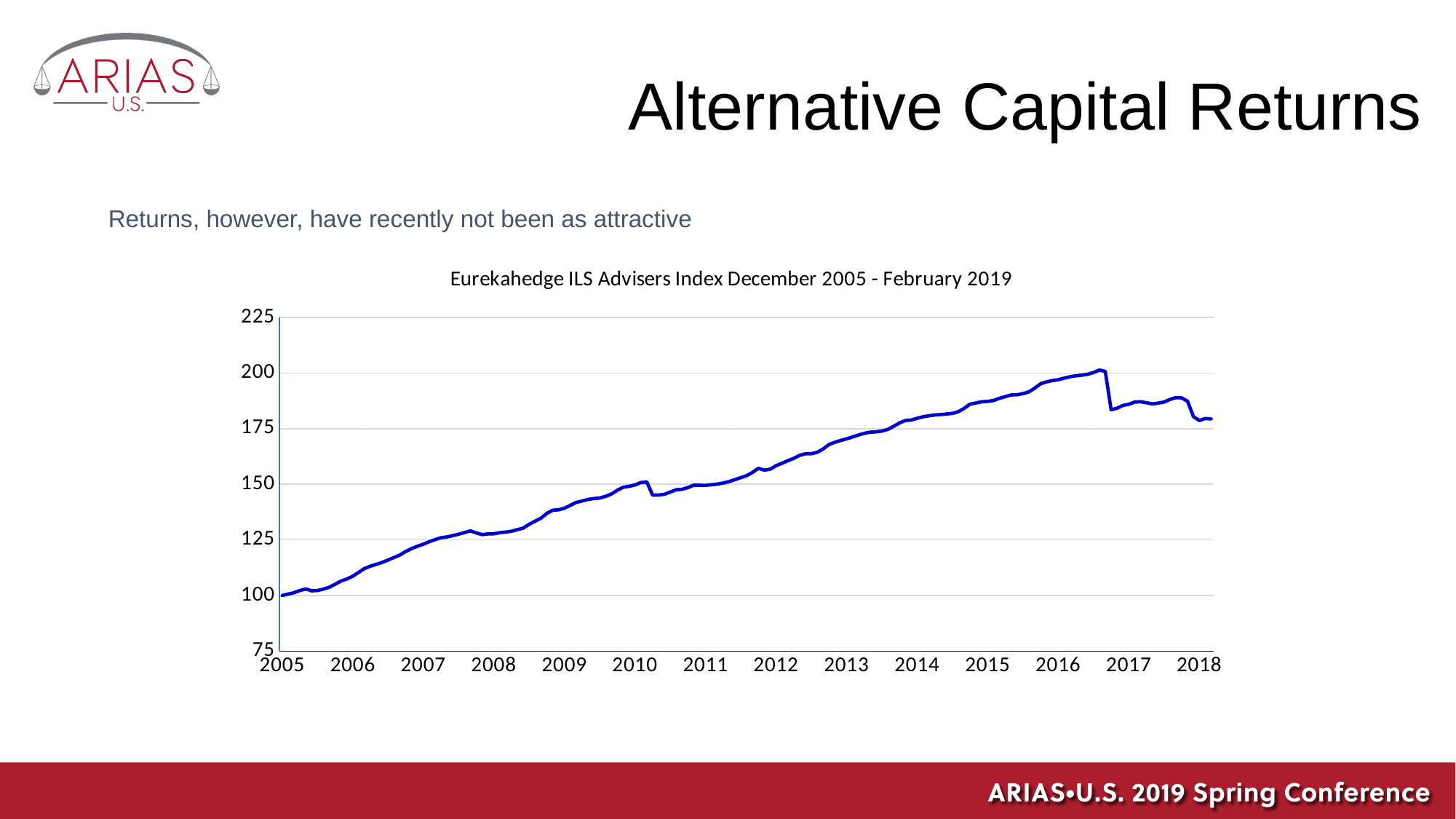
Is the value of the index at 2016 greater or less than 175? greater Is the value of the index at 2010 greater or less than 125? greater Does the index generally rise or fall from 2005 to 2016? rise What is the value of the index at the start of the line in 2005? 100 In which year does the index reach its highest point? 2017 Is the value of the index at 2008 greater or less than 150? less In which year is the index at its lowest point? 2005 What kind of chart is shown on the slide? line chart Which is larger, the index value at 2012 or at 2008? 2012 How many year labels are shown on the x axis? 14 What is the title of the chart? Eurekahedge ILS Advisers Index December 2005 - February 2019